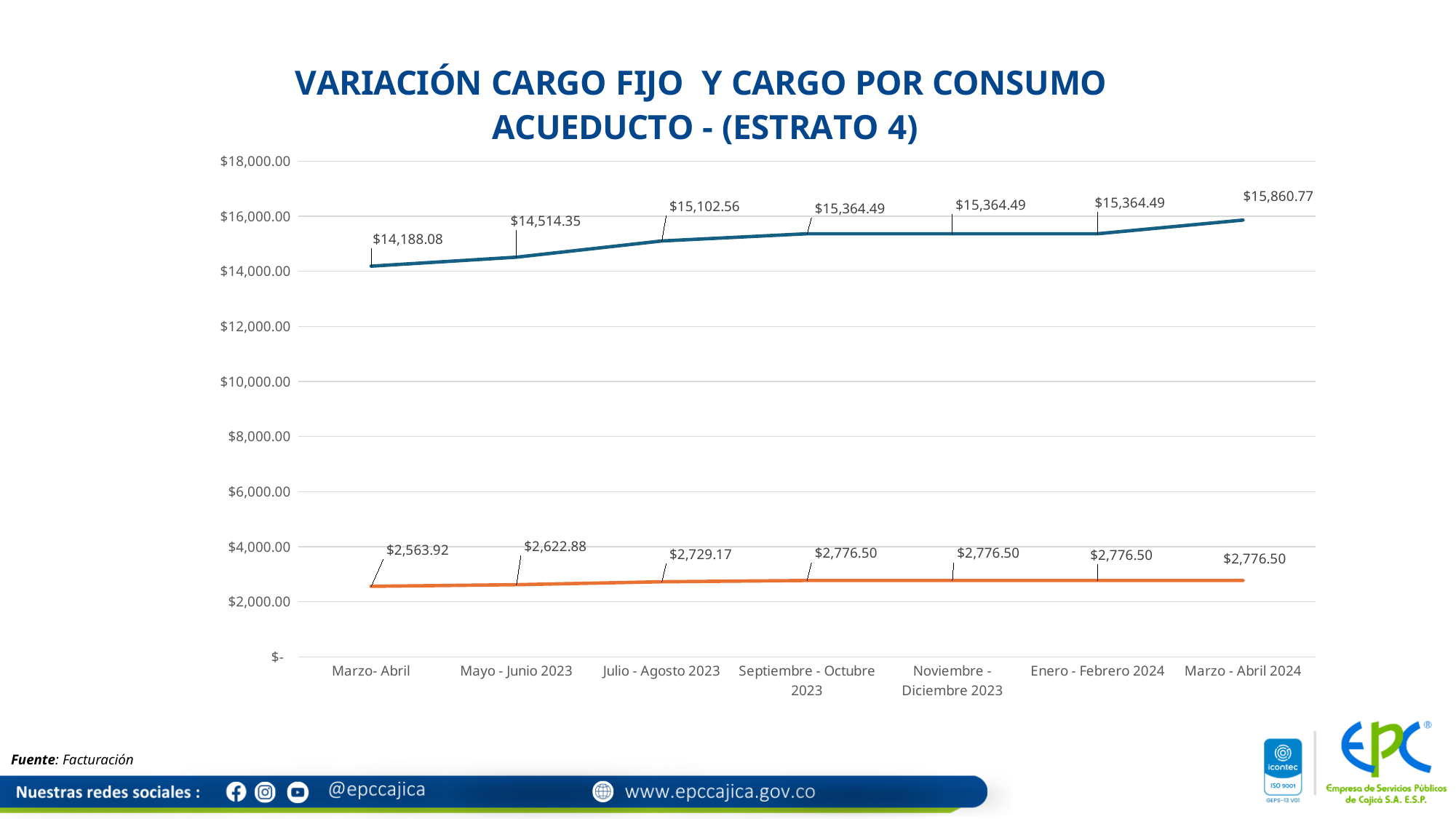
What is the value of the lower orange line for Mayo - Junio 2023? $2,622.88 What is the value of the upper blue line for Marzo - Abril 2024? $15,860.77 How many periods are shown on the x axis? 7 What type of chart is shown on the slide? Line chart By how much does the upper blue line increase from Marzo- Abril to Marzo - Abril 2024? $1,672.69 In which period does the lower orange line have its lowest value? Marzo- Abril What is the value of the lower orange line for Julio - Agosto 2023? $2,729.17 Do the values of the upper blue line generally rise or fall from left to right? Rise Which is larger: the upper blue line's value for Mayo - Junio 2023 or for Septiembre - Octubre 2023? Septiembre - Octubre 2023 In which period does the upper blue line reach its highest value? Marzo - Abril 2024 What is the value of the upper blue line for Marzo- Abril? $14,188.08 What is the difference between the upper blue line's values for Julio - Agosto 2023 and Mayo - Junio 2023? $588.21